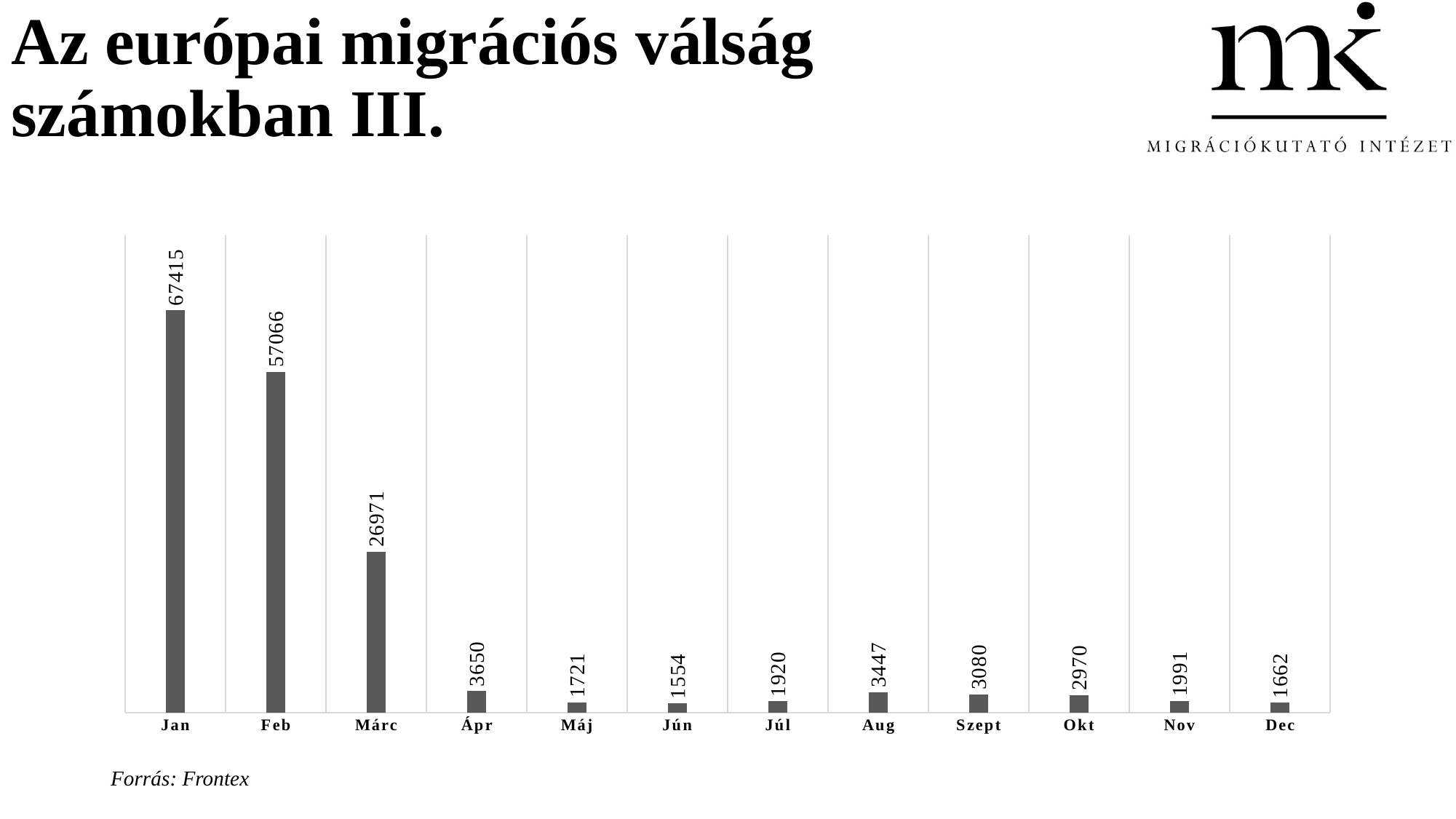
What source is cited below the chart? Frontex How many months are shown on the x axis? 12 What is the value for Dec? 1662 What is the difference between the values for Ápr and Aug? 203 What is the value for Jan? 67415 Which is larger, the value for Okt or the value for Nov? Okt What is the value for Szept? 3080 What is the value for Márc? 26971 Which month has the highest value? Jan What is the difference between the values for Jan and Feb? 10349 What kind of chart is shown on the slide? bar chart Which month has the lowest value? Jún